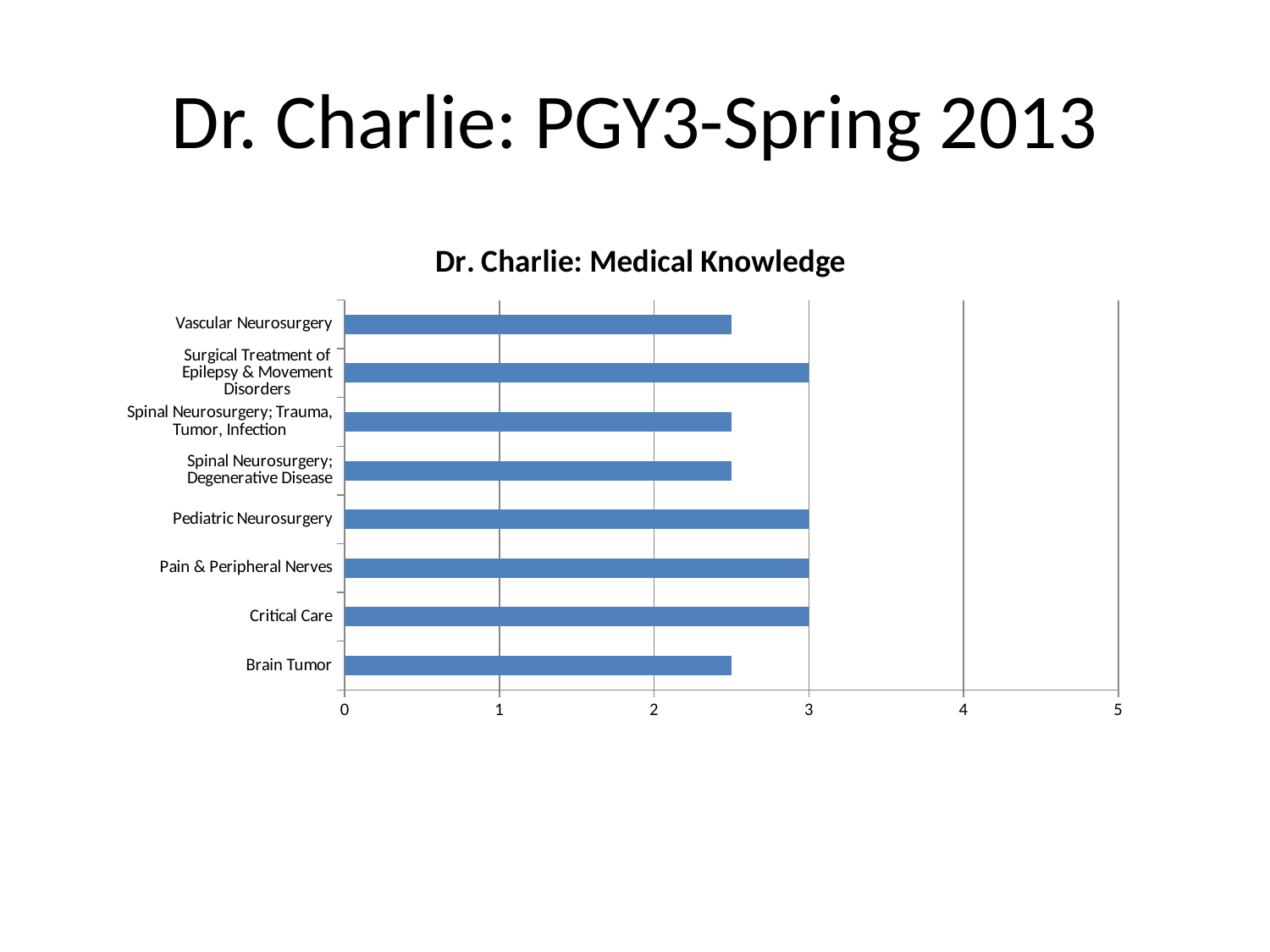
Which is larger, the value for Critical Care or the value for Brain Tumor? Critical Care What is the maximum value shown on the horizontal axis? 5 Is the value for Spinal Neurosurgery; Degenerative Disease greater or less than 3? less Is the value for Vascular Neurosurgery greater or less than 2? greater What is the value for Critical Care? 3 Is the value for Brain Tumor greater or less than 3? less What is the value for Pediatric Neurosurgery? 3 What is the title of the chart? Dr. Charlie: Medical Knowledge What is the value for Pain & Peripheral Nerves? 3 What is the value for Surgical Treatment of Epilepsy & Movement Disorders? 3 How many categories are plotted in the chart? 8 What type of chart is shown on the slide? Bar chart